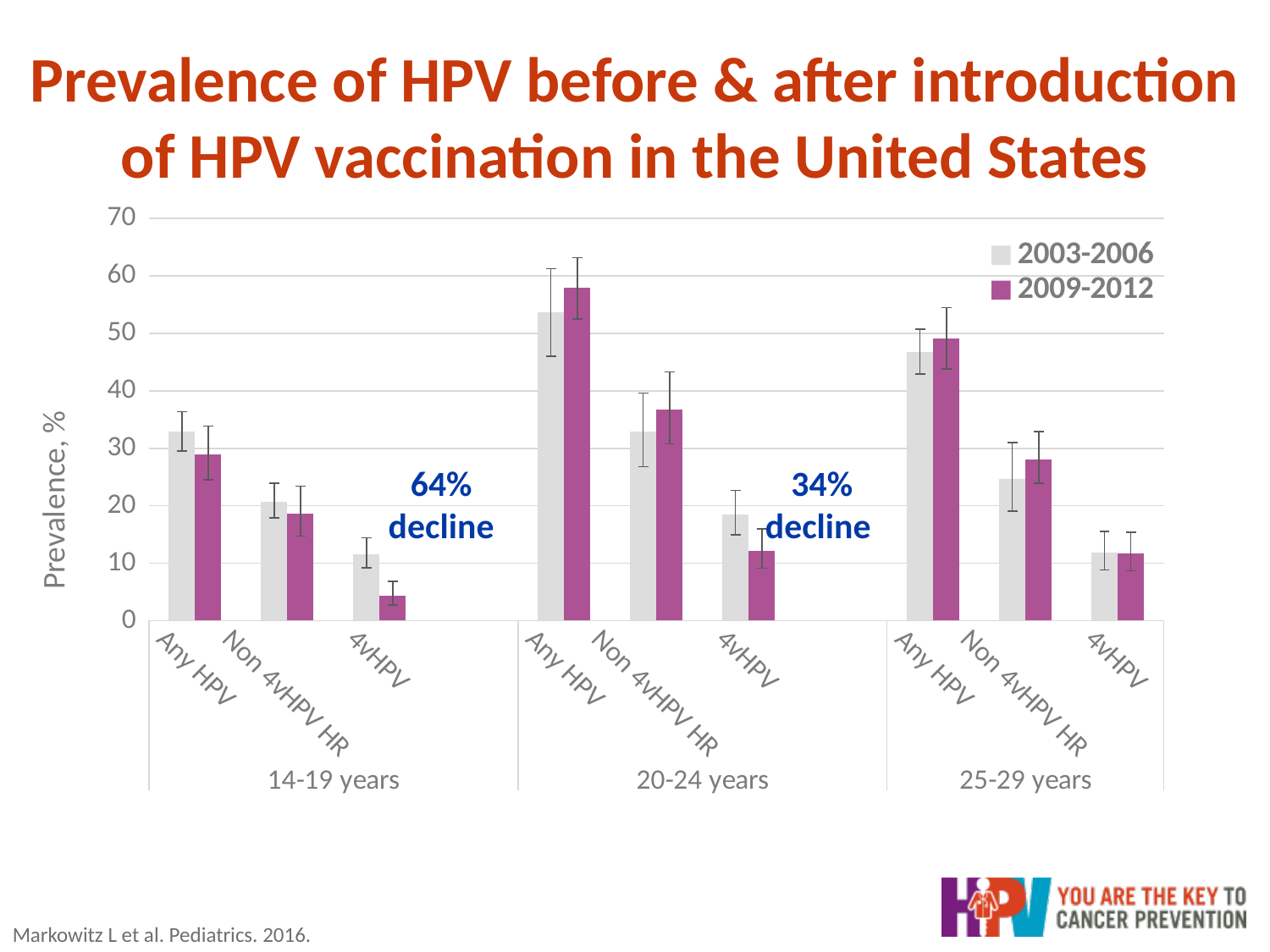
Is the 2009-2012 value for Any HPV in the 20-24 years group greater or less than 50? greater For 4vHPV in the 14-19 years group, which period has the larger value, 2003-2006 or 2009-2012? 2003-2006 Is the 2009-2012 value for 4vHPV in the 14-19 years group greater or less than 10? less For 4vHPV in the 20-24 years group, which period has the larger value, 2003-2006 or 2009-2012? 2003-2006 How many age groups are shown along the x axis? 3 How many series does the legend list? 2 Is the 2003-2006 value for Any HPV in the 14-19 years group greater or less than 30? greater Which age group has the highest Any HPV prevalence? 20-24 years Within the 14-19 years group, which HPV category has the lowest 2009-2012 prevalence? 4vHPV What is the label on the y axis? Prevalence, % What type of chart is shown on the slide? bar chart What are the two time periods listed in the legend? 2003-2006 and 2009-2012